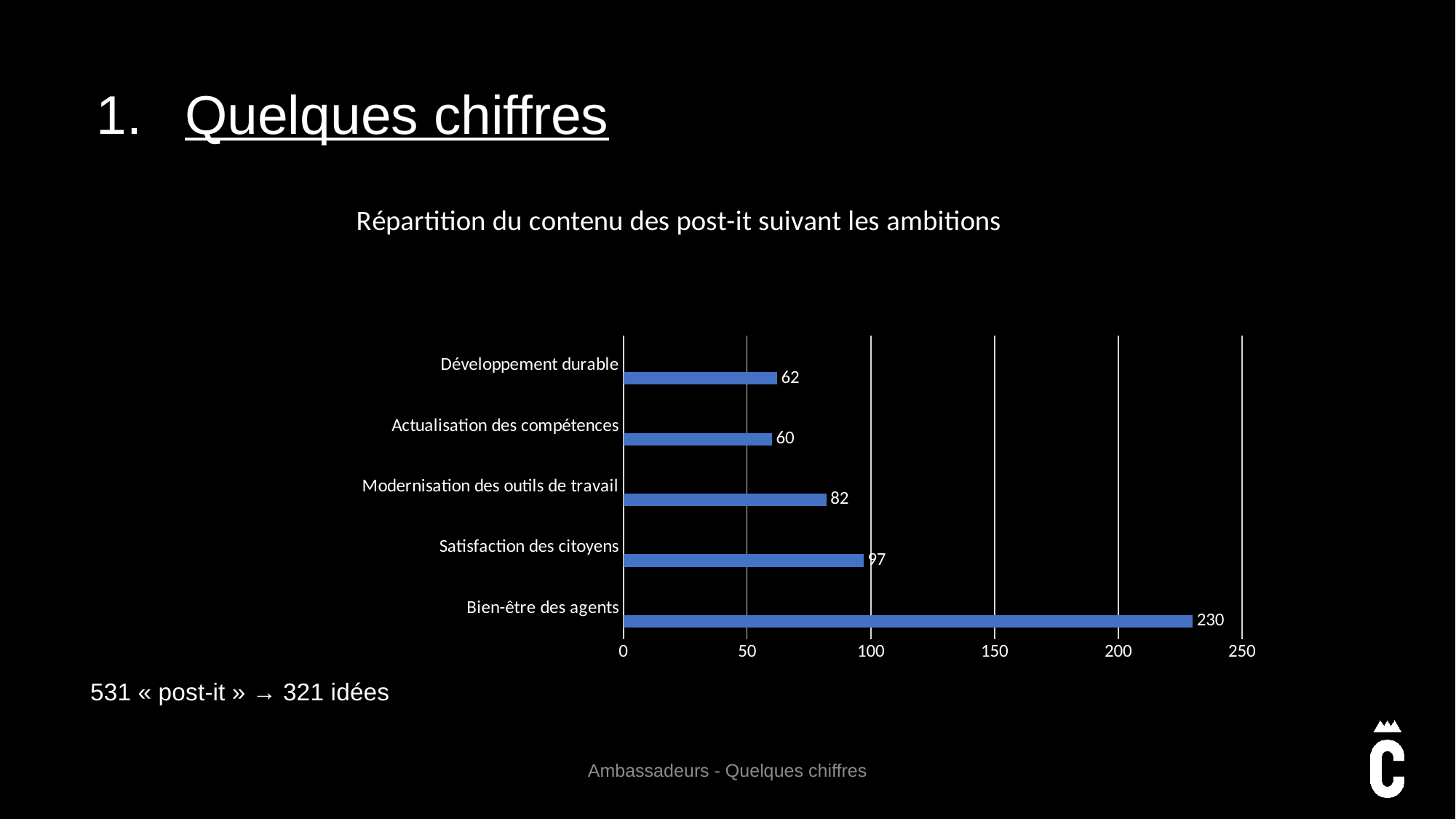
Which category has the highest value? Bien-être des agents What kind of chart is shown on the slide? bar chart What is the difference between the values for Bien-être des agents and Satisfaction des citoyens? 133 Which is larger, the value for Satisfaction des citoyens or the value for Modernisation des outils de travail? Satisfaction des citoyens How many categories are shown in the chart? 5 What is the difference between the values for Modernisation des outils de travail and Développement durable? 20 What is the value for Actualisation des compétences? 60 What is the value for Modernisation des outils de travail? 82 Is the value for Bien-être des agents greater or less than 200? greater Which category has the lowest value? Actualisation des compétences What is the value for Bien-être des agents? 230 What is the value for Satisfaction des citoyens? 97